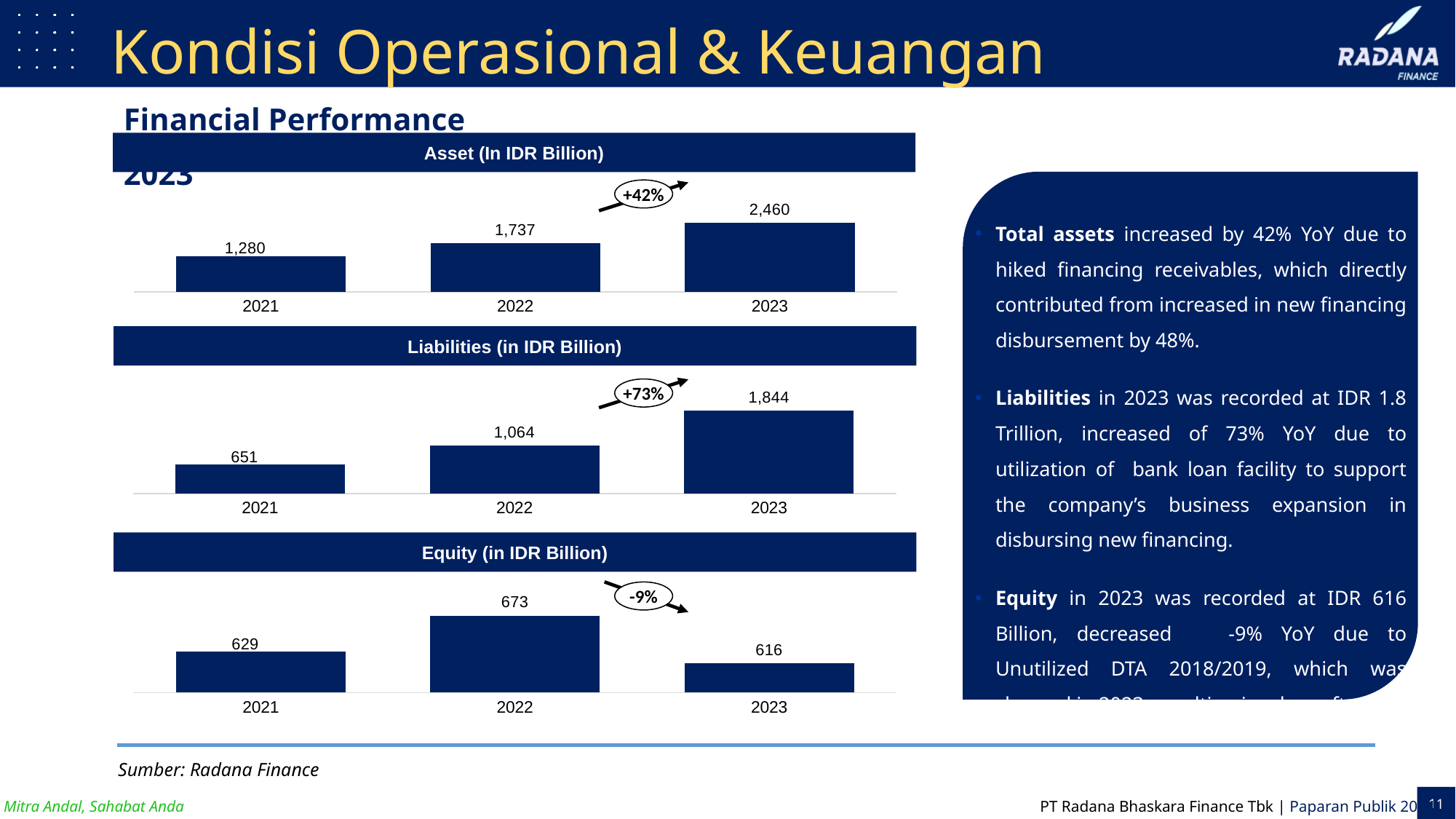
How many years are shown in the Asset (In IDR Billion) chart? 3 In the Asset (In IDR Billion) chart, what is the difference between the 2023 and 2022 values? 723 In the Liabilities (in IDR Billion) chart, what is the value for 2022? 1,064 In the Liabilities (in IDR Billion) chart, which year has the lowest value? 2021 In the Equity (in IDR Billion) chart, which year has the highest value? 2022 In the Liabilities (in IDR Billion) chart, which is larger, the value for 2023 or the value for 2022? 2023 What type of chart is the Liabilities (in IDR Billion) chart? Bar chart In the Equity (in IDR Billion) chart, what is the difference between the 2022 and 2021 values? 44 In the Asset (In IDR Billion) chart, what is the value for 2023? 2,460 In the Equity (in IDR Billion) chart, what is the value for 2023? 616 In the Asset (In IDR Billion) chart, what is the value for 2021? 1,280 In the Asset (In IDR Billion) chart, do the values rise or fall from 2021 to 2023? Rise